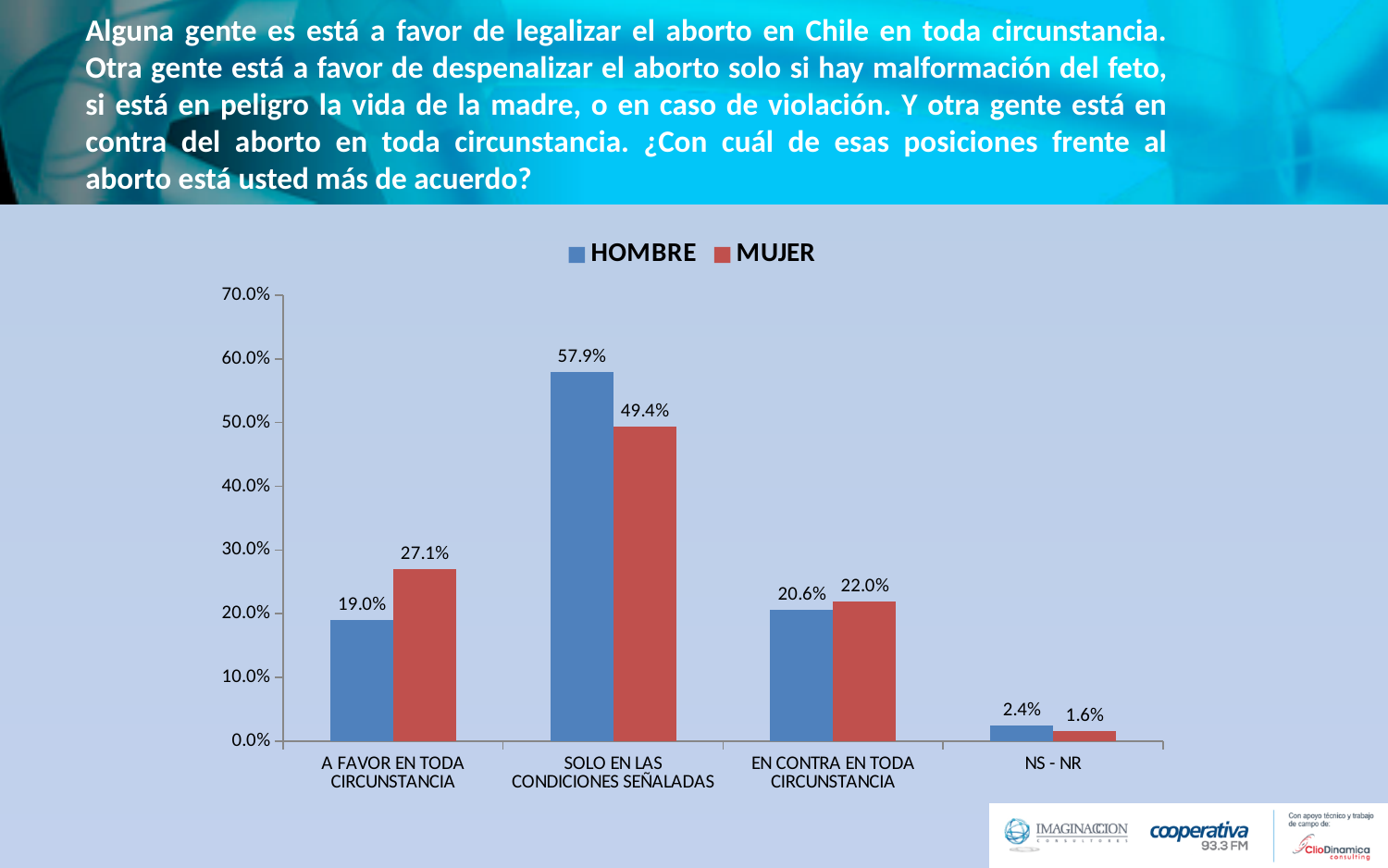
What is the difference between the HOMBRE and MUJER values in the SOLO EN LAS CONDICIONES SEÑALADAS category? 8.5% Is the HOMBRE value for A FAVOR EN TODA CIRCUNSTANCIA greater or less than 20.0%? less What colour represents the MUJER series? red Which category has the highest value for HOMBRE? SOLO EN LAS CONDICIONES SEÑALADAS How many categories are shown on the x axis? 4 What is the value for MUJER in the A FAVOR EN TODA CIRCUNSTANCIA category? 27.1% What kind of chart is shown on the slide? bar chart What is the value for HOMBRE in the SOLO EN LAS CONDICIONES SEÑALADAS category? 57.9% How many series does the legend list? 2 What is the value for MUJER in the NS - NR category? 1.6% Which category has the lowest value for MUJER? NS - NR In the EN CONTRA EN TODA CIRCUNSTANCIA category, which series has the larger value, HOMBRE or MUJER? MUJER